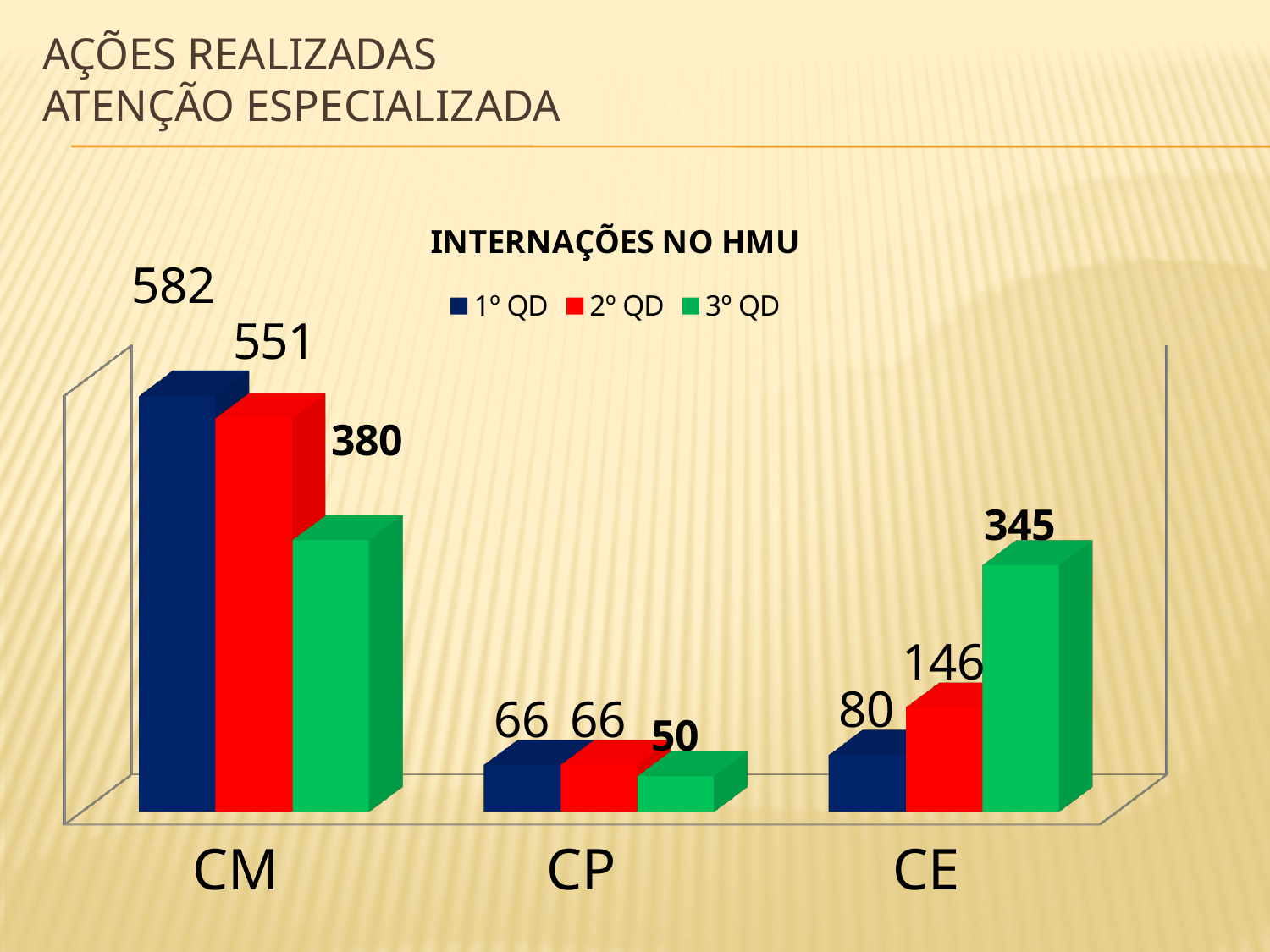
How many categories are shown on the x axis? 3 What is the value for 1º QD in the CM category? 582 What is the title of the chart? INTERNAÇÕES NO HMU How many series does the legend list? 3 What is the value for 3º QD in the CE category? 345 What is the difference between the 3º QD and 1º QD values for CE? 265 Which category has the highest 1º QD value? CM What is the value for 2º QD in the CP category? 66 What is the difference between the 1º QD and 2º QD values for CM? 31 Which is larger for CE: the 2º QD value or the 3º QD value? 3º QD Which category has the lowest 3º QD value? CP What kind of chart is shown? Bar chart